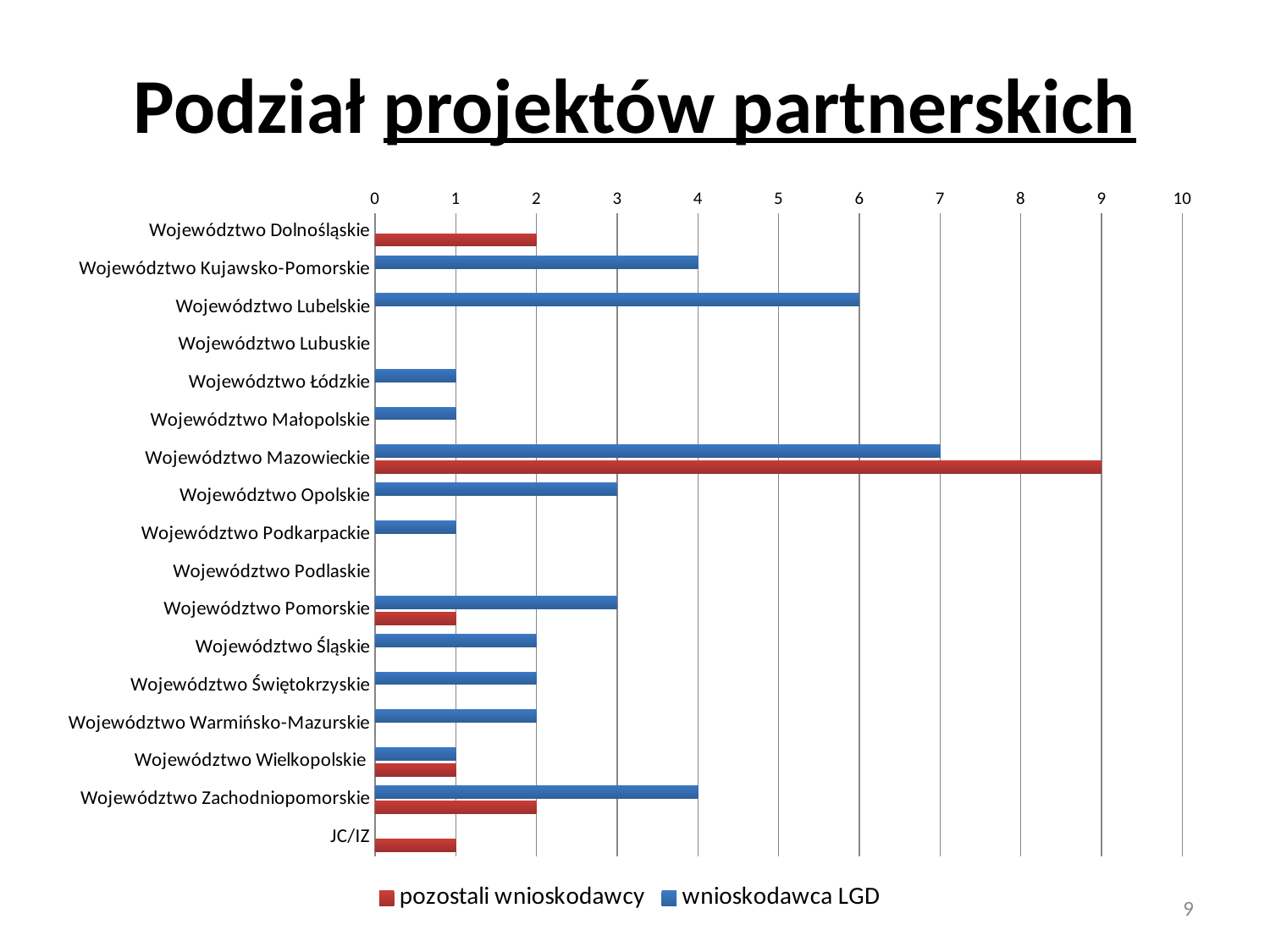
What is the value of "pozostali wnioskodawcy" for Województwo Mazowieckie? 9 Which has a larger "wnioskodawca LGD" value: Województwo Kujawsko-Pomorskie or Województwo Opolskie? Województwo Kujawsko-Pomorskie For Województwo Mazowieckie, what is the difference between "pozostali wnioskodawcy" and "wnioskodawca LGD"? 2 Is the "wnioskodawca LGD" value for Województwo Lubelskie greater or less than 5? greater How many series does the legend list? 2 Which category has the highest value for "wnioskodawca LGD"? Województwo Mazowieckie What is the value of "wnioskodawca LGD" for Województwo Lubelskie? 6 What kind of chart is shown on the slide? bar chart How many categories are listed on the vertical axis of the chart? 17 What is the value of "wnioskodawca LGD" for Województwo Zachodniopomorskie? 4 Which colour represents the series "wnioskodawca LGD" in the legend? blue Which category has the highest value for "pozostali wnioskodawcy"? Województwo Mazowieckie